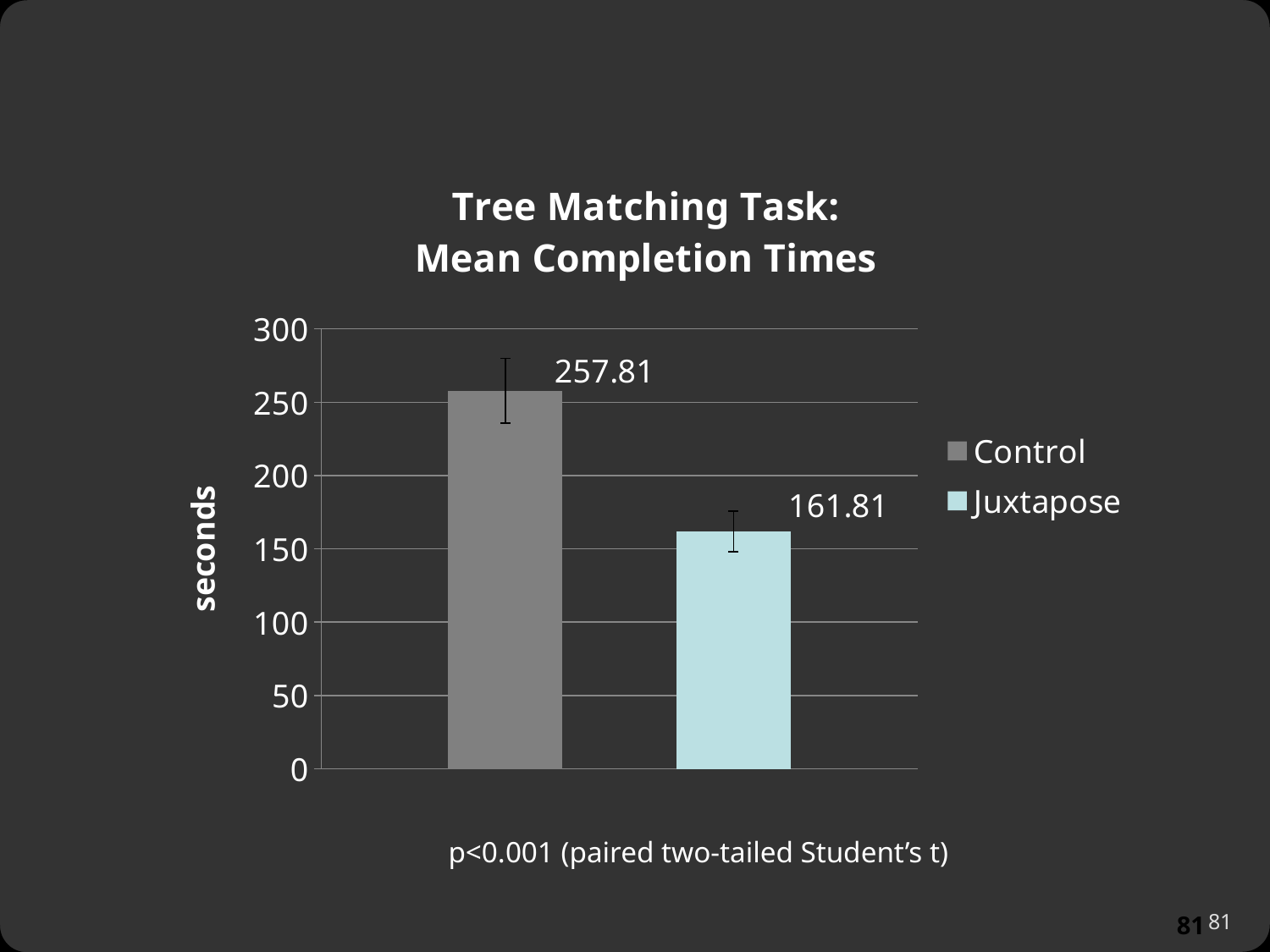
Which series has the lowest mean completion time? Juxtapose What is the label on the vertical axis? seconds What is the mean completion time for Juxtapose? 161.81 What is the difference between the Control and Juxtapose mean completion times? 96 Which is larger, the Control value or the Juxtapose value? Control Which series has the highest mean completion time? Control How many bars are plotted in the chart? 2 What is the mean completion time for Control? 257.81 What kind of chart is shown? bar chart Is the value for Control greater or less than 250? greater How many series does the legend list? 2 Is the value for Juxtapose greater or less than 200? less